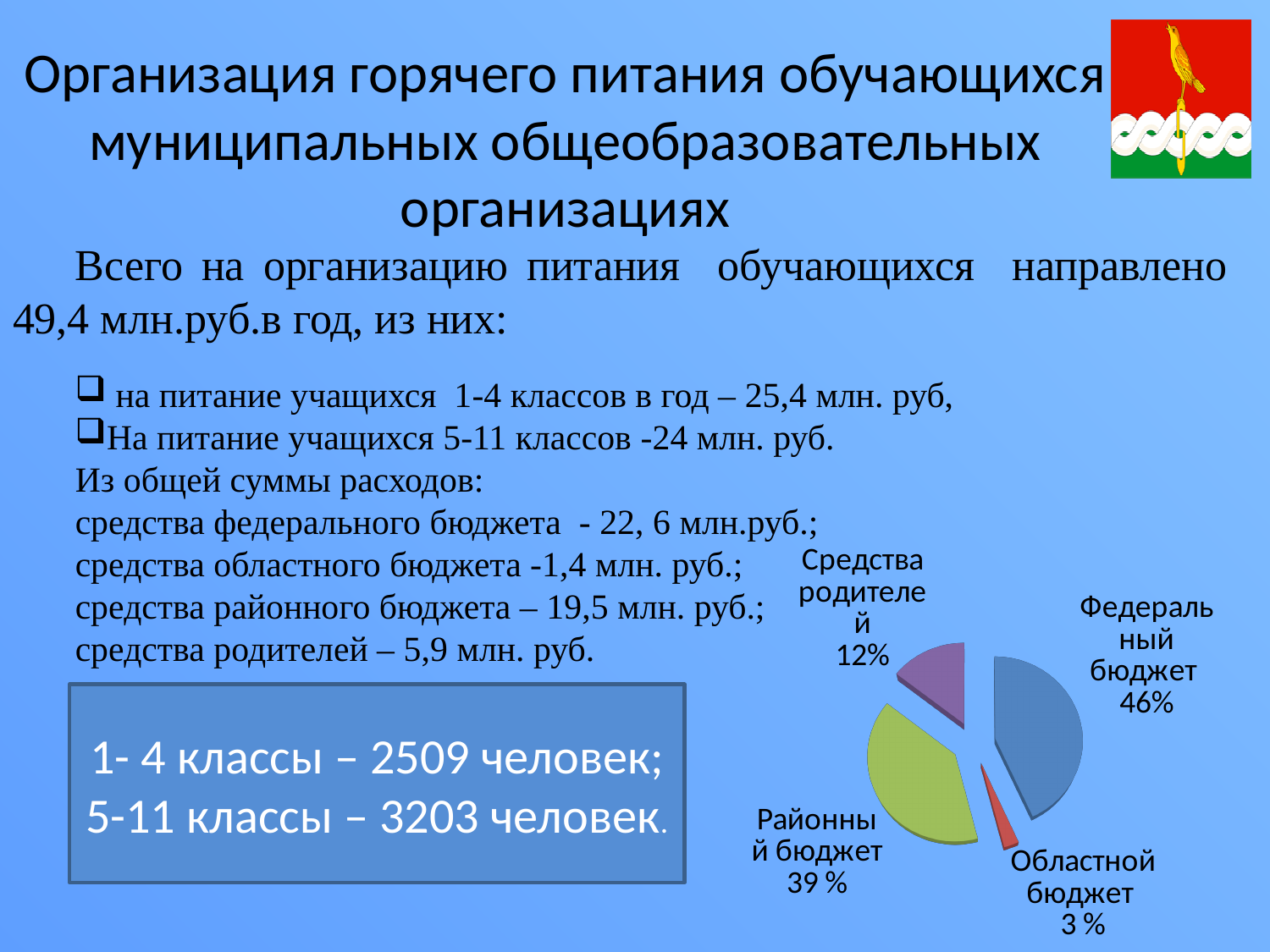
What share of the pie does Средства родителей have? 12% What is the difference in percentage points between Федеральный бюджет and Районный бюджет? 7 What share of the pie does Областной бюджет have? 3 % What share of the pie does Федеральный бюджет have? 46% What colour is the Федеральный бюджет slice in the pie chart? blue Which slice of the pie chart is the smallest? Областной бюджет How many slices does the pie chart have? 4 Which slice of the pie chart is the largest? Федеральный бюджет What kind of chart is shown on the slide? pie chart Which is larger in the pie chart: Районный бюджет or Средства родителей? Районный бюджет What is the difference in percentage points between Средства родителей and Областной бюджет? 9